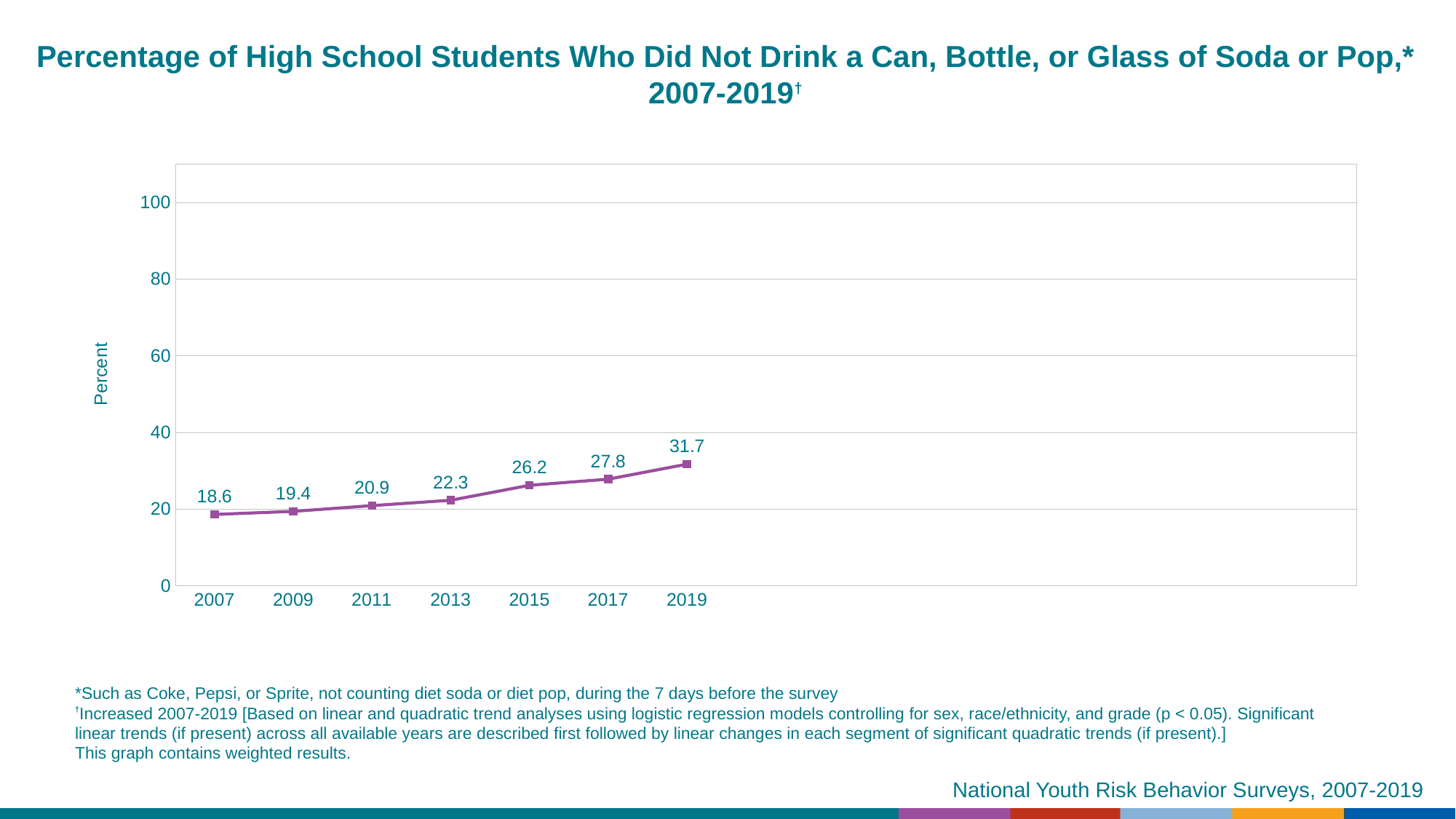
Is the value for 2019 greater or less than 40? less Which year has the lowest percentage? 2007 Which year has the highest percentage? 2019 What kind of chart is shown on the slide? line chart What value is plotted for 2013? 22.3 What is the difference between the 2019 value and the 2007 value? 13.1 How many years are plotted on the chart? 7 Which year has a larger value, 2011 or 2015? 2015 What was the percentage of high school students who did not drink soda or pop in 2007? 18.6 What was the percentage of high school students who did not drink soda or pop in 2019? 31.7 What is the difference between the 2017 value and the 2015 value? 1.6 Do the values rise or fall from 2007 to 2019? rise